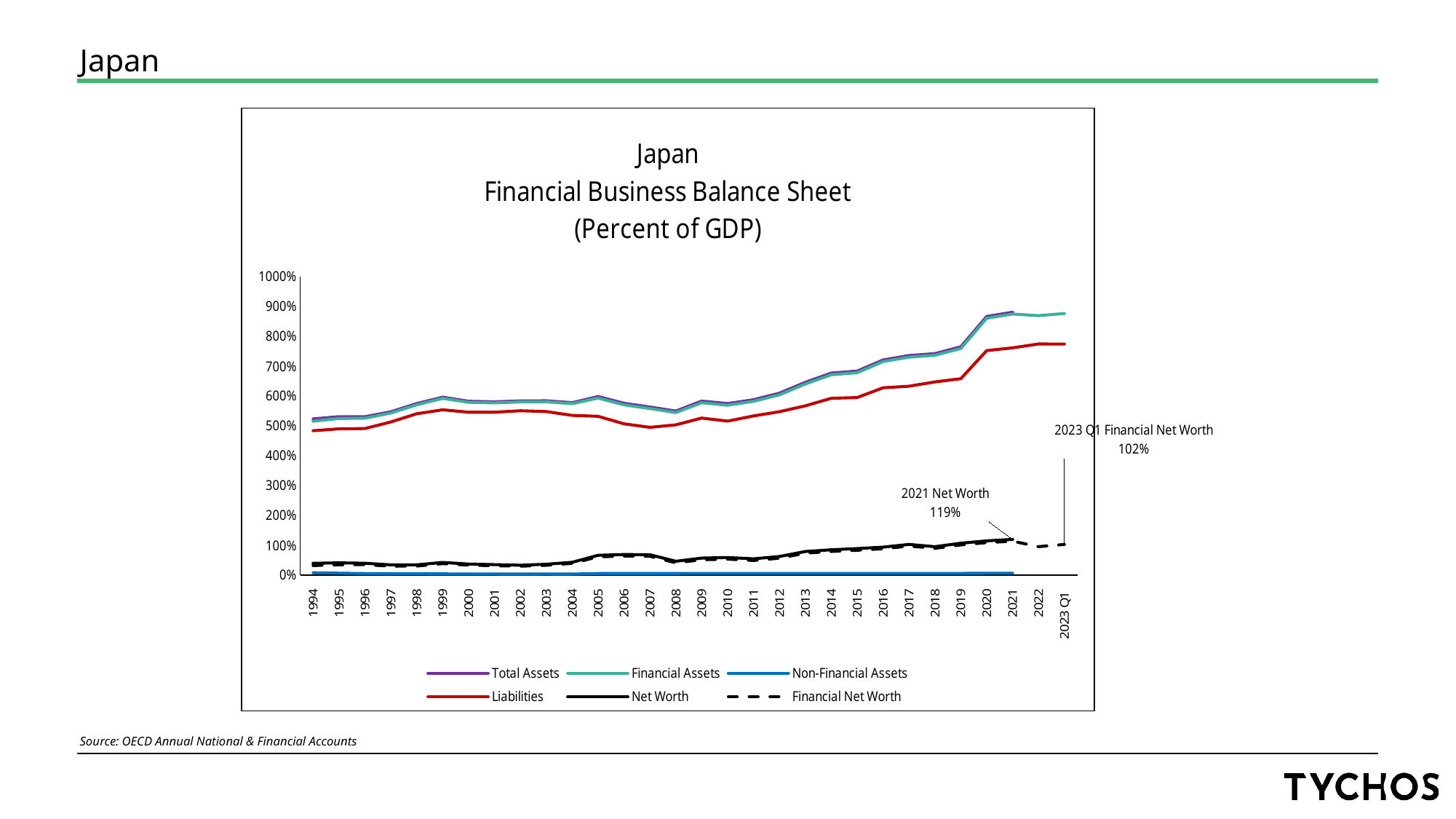
How many time points are shown on the x axis? 30 What kind of chart is shown on the slide? Line chart What is the difference between the labelled 2021 Net Worth and the labelled 2023 Q1 Financial Net Worth? 17 percentage points Which series is drawn with a dashed line? Financial Net Worth Is the value for Liabilities in 2021 greater or less than 700%? greater Is the value for Total Assets in 1994 greater or less than 600%? less In 2021, which is larger: Total Assets or Liabilities? Total Assets What is the Net Worth value labelled for 2021? 119% What is the Financial Net Worth value labelled for 2023 Q1? 102% Do Total Assets generally rise or fall from 1994 to 2023 Q1? Rise How many series does the legend list? 6 Which series is the lowest across the whole chart? Non-Financial Assets